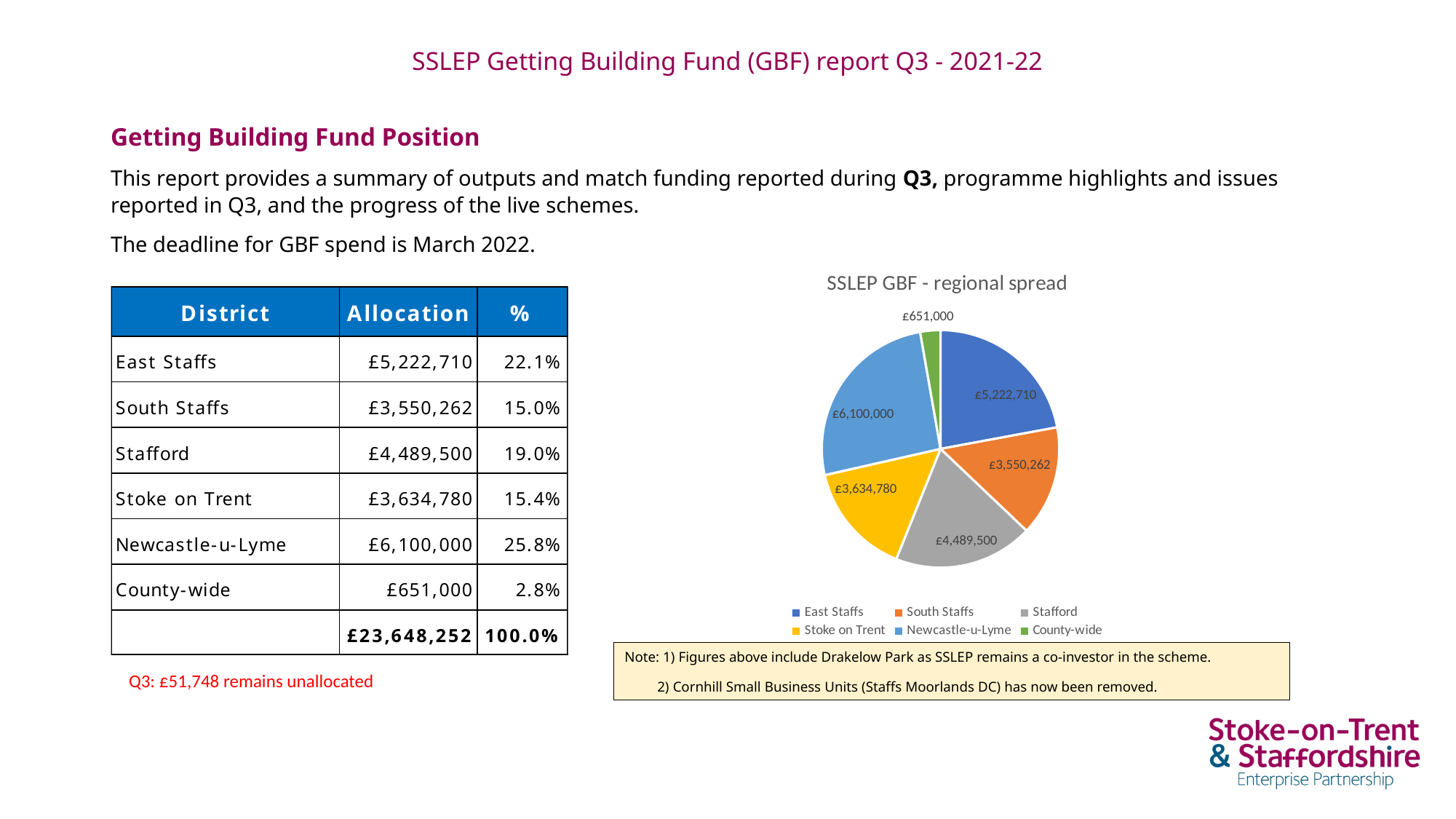
How many slices does the pie chart have? 6 What is the value of the County-wide slice in the pie chart? £651,000 How many entries does the chart legend list? 6 Which district has the smallest slice in the pie chart? County-wide Which district has the largest slice in the pie chart? Newcastle-u-Lyme What is the difference between the Newcastle-u-Lyme and East Staffs values in the pie chart? £877,290 What share of the total does the Stafford slice represent? 19.0% What is the value of the Newcastle-u-Lyme slice in the pie chart? £6,100,000 Which is larger in the pie chart, the Stafford slice or the South Staffs slice? Stafford What is the value of the East Staffs slice in the pie chart? £5,222,710 What is the title of the chart? SSLEP GBF - regional spread What type of chart is shown on the slide? pie chart